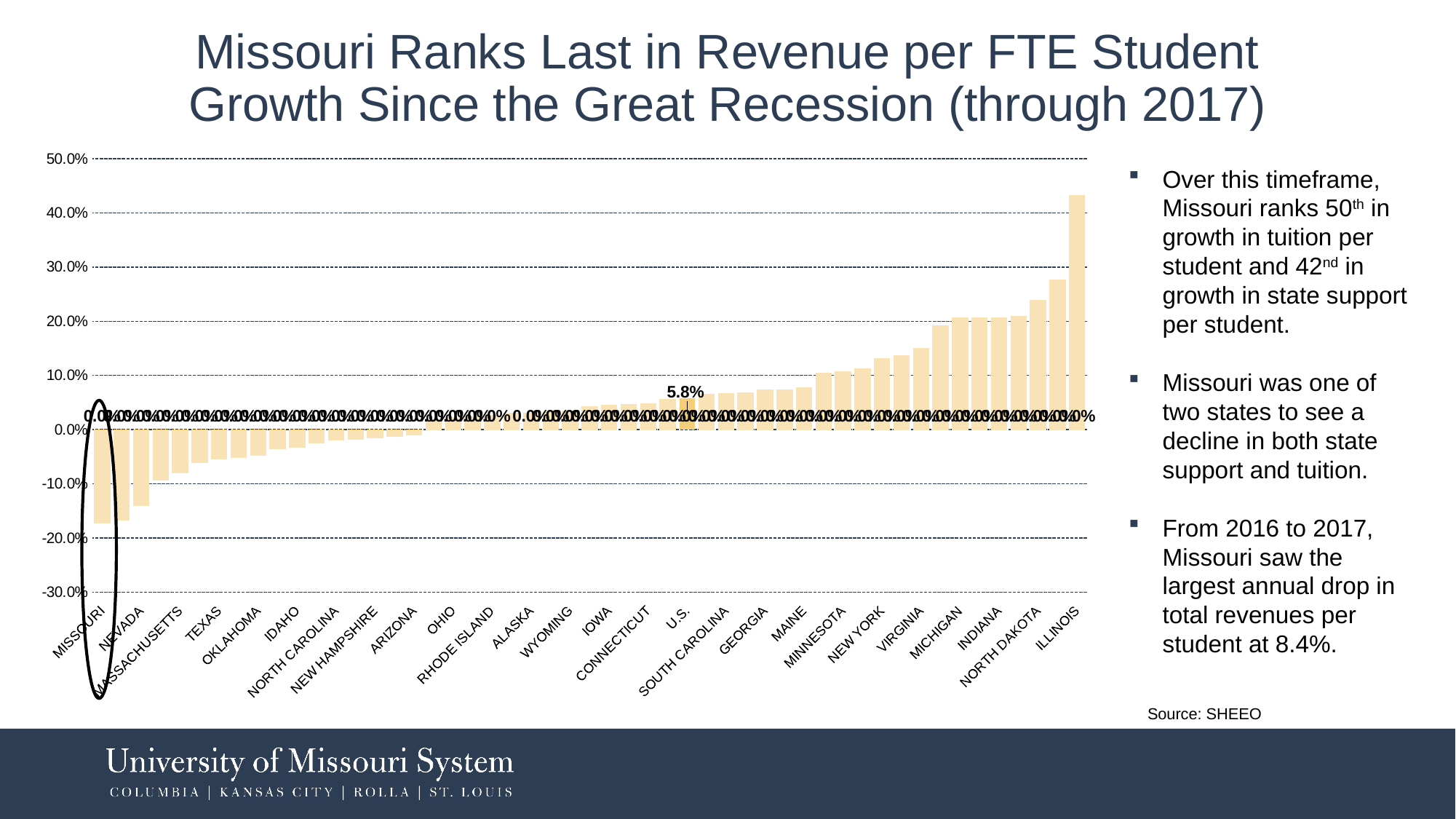
Is the value for North Dakota greater or less than 20.0%? greater What kind of chart is shown on the slide? bar chart Which state has the lowest bar in the chart? Missouri Is the value for Illinois greater or less than 40.0%? greater Which state has the highest bar in the chart? Illinois What is the value labeled for U.S. in the chart? 5.8% Is the value for Michigan greater or less than 10.0%? greater Which state's bar is circled in the chart? Missouri Which has the larger value, Nevada or Texas? Texas What is the title of the slide containing the chart? Missouri Ranks Last in Revenue per FTE Student Growth Since the Great Recession (through 2017) Do the bar values rise or fall moving from left to right along the x axis? rise